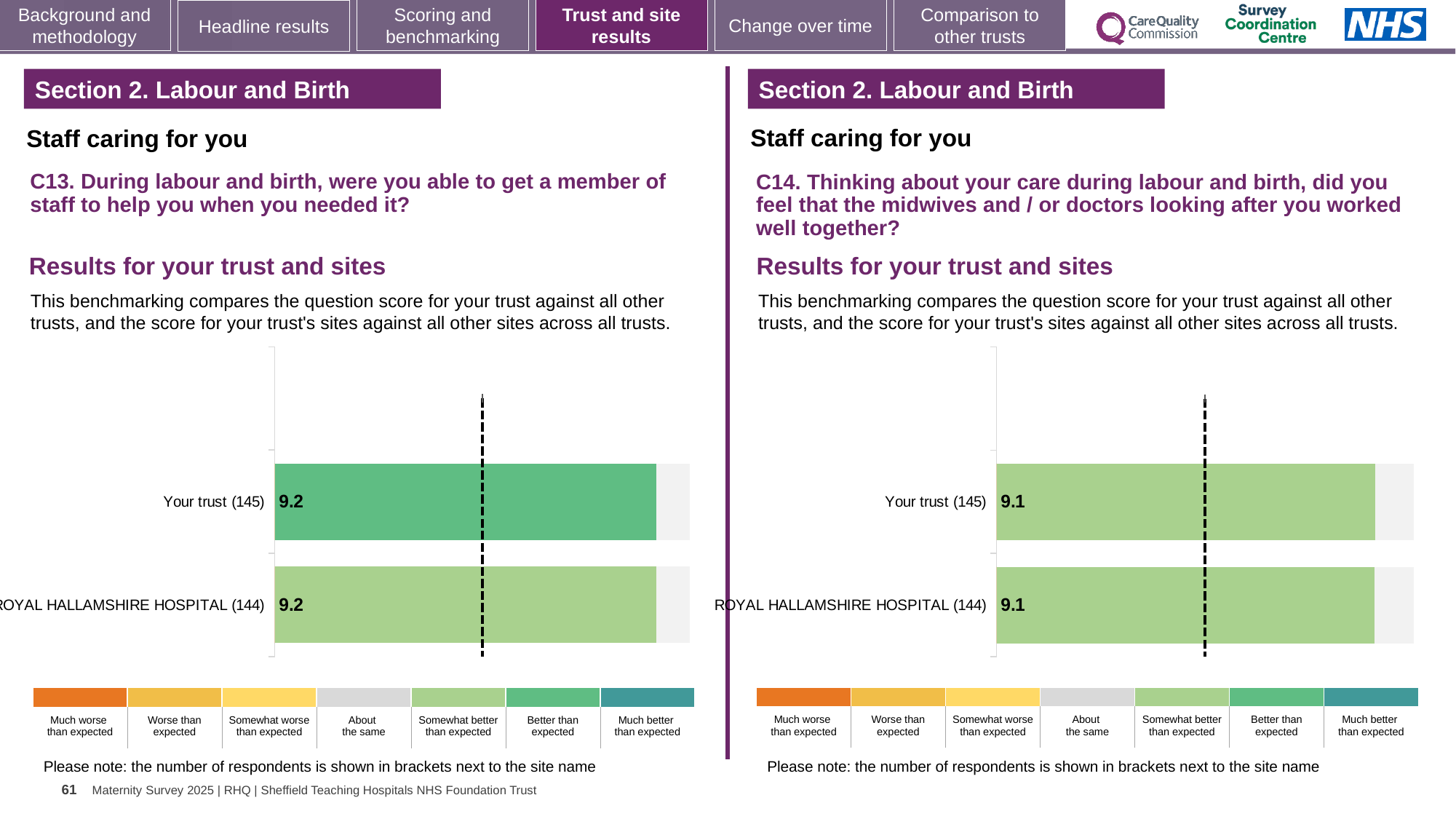
In the C13 chart on the left, what is the score for ROYAL HALLAMSHIRE HOSPITAL (144)? 9.2 What kind of chart is used for the C13 results on the left? Bar chart In the C13 chart on the left, what is the difference between the score for Your trust and the score for ROYAL HALLAMSHIRE HOSPITAL? 0.0 How many bars are plotted in the C14 chart on the right? 2 How many benchmark categories does the colour key below the C13 chart on the left list? 7 How many bars are plotted in the C13 chart on the left? 2 In the C14 chart on the right, what is the score for Your trust (145)? 9.1 In the C14 chart on the right, what is the score for ROYAL HALLAMSHIRE HOSPITAL (144)? 9.1 In the C13 chart on the left, what is the score for Your trust (145)? 9.2 In the C14 chart on the right, what is the difference between the score for Your trust and the score for ROYAL HALLAMSHIRE HOSPITAL? 0.0 In the C13 chart on the left, which benchmark category does the colour of the Your trust bar correspond to? Better than expected How many respondents are shown in brackets for ROYAL HALLAMSHIRE HOSPITAL in the C14 chart on the right? 144